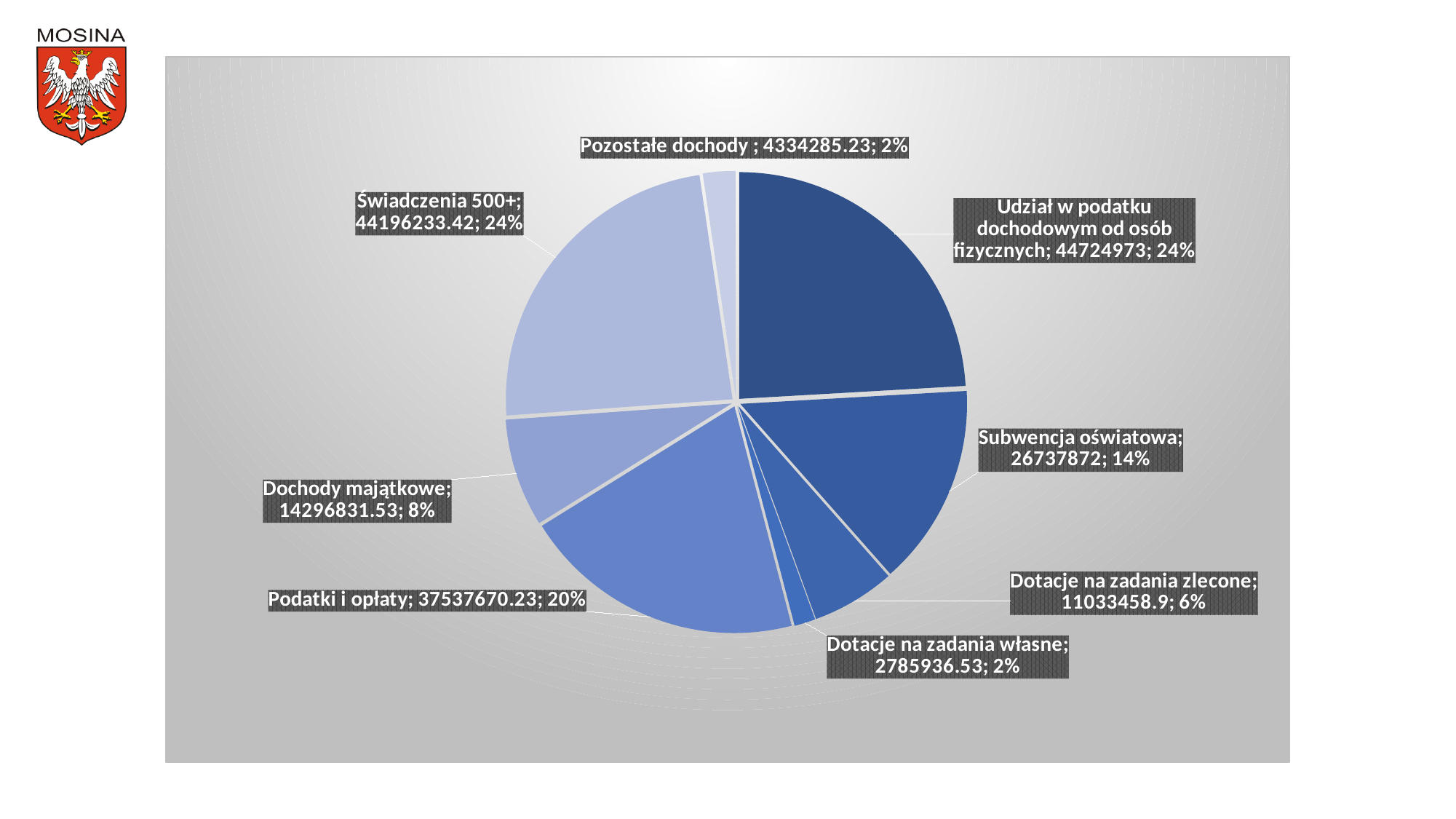
What kind of chart is shown on the slide? pie chart What share of the pie does Subwencja oświatowa represent? 14% Which is larger, Podatki i opłaty or Subwencja oświatowa? Podatki i opłaty What is the difference between the values for Subwencja oświatowa and Dotacje na zadania zlecone? 15704413.1 What value is shown for Podatki i opłaty? 37537670.23 What value is shown for Świadczenia 500+? 44196233.42 How many slices does the pie chart have? 8 What share of the pie does Dochody majątkowe represent? 8% What value is shown for Dochody majątkowe? 14296831.53 What value is shown for Dotacje na zadania zlecone? 11033458.9 Which is larger, Dotacje na zadania zlecone or Dotacje na zadania własne? Dotacje na zadania zlecone What value is shown for Subwencja oświatowa? 26737872